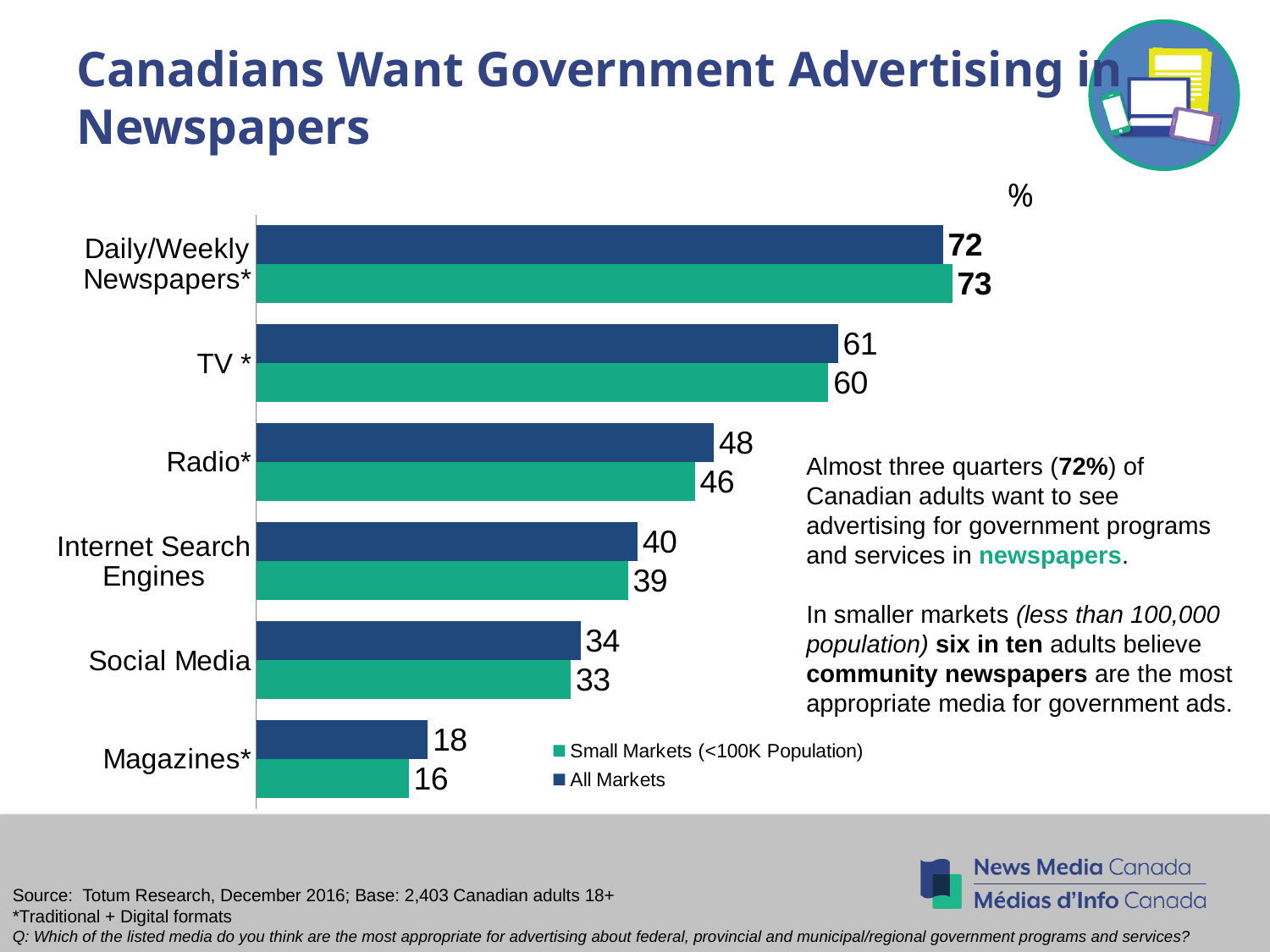
What is the Small Markets (<100K Population) value for Radio*? 46 Which category has the lowest All Markets value? Magazines* Which category has the highest Small Markets (<100K Population) value? Daily/Weekly Newspapers* What is the difference between the All Markets and Small Markets (<100K Population) values for Magazines*? 2 What is the Small Markets (<100K Population) value for Daily/Weekly Newspapers*? 73 How many series does the legend list? 2 What kind of chart is shown on the slide? Bar chart What is the All Markets value for Daily/Weekly Newspapers*? 72 How many media categories are shown in the chart? 6 What is the difference between the All Markets values for TV * and Radio*? 13 Which is larger for Internet Search Engines: the All Markets value or the Small Markets (<100K Population) value? All Markets What is the All Markets value for Social Media? 34